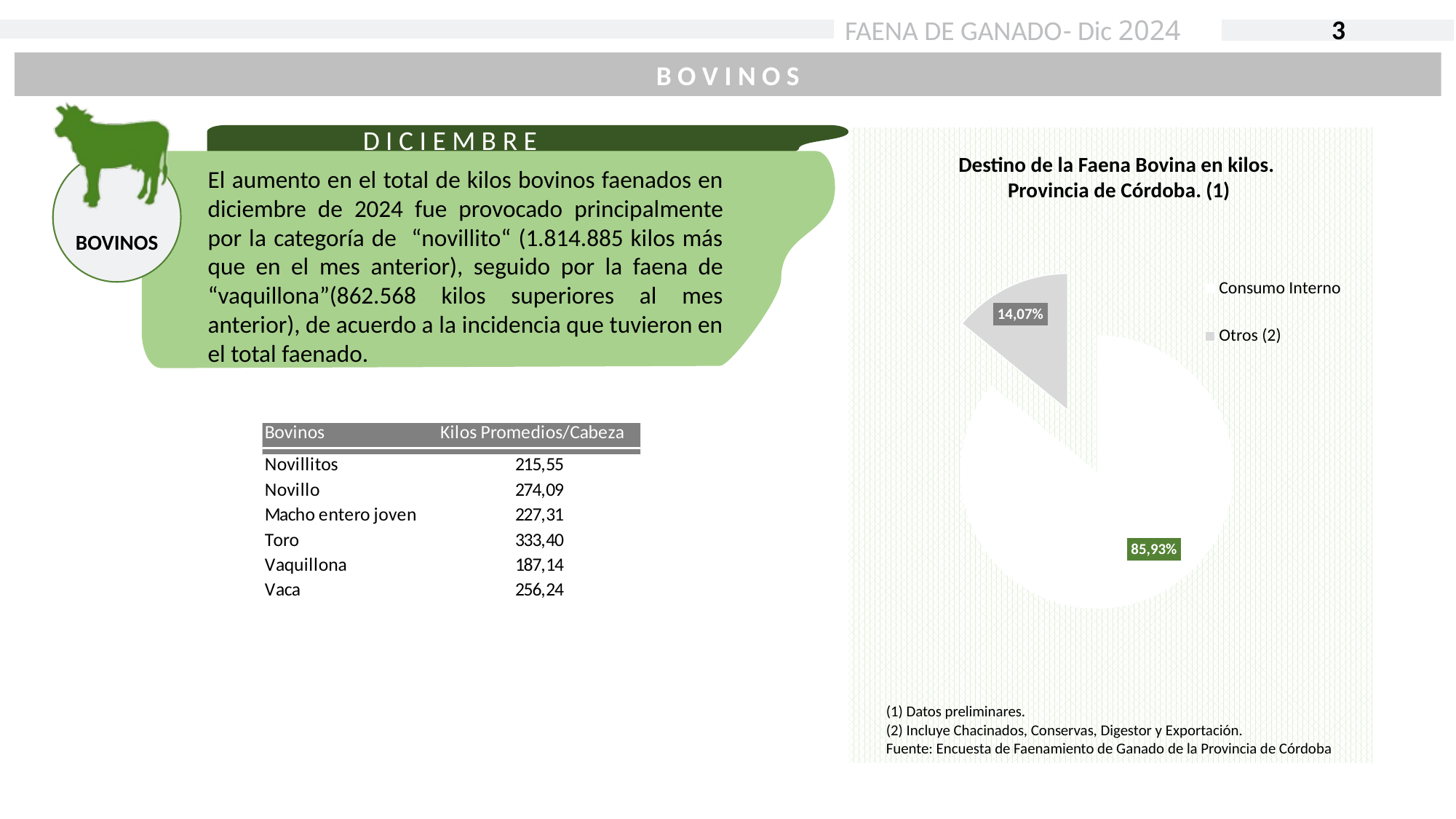
Which slice of the pie chart is the smallest? Otros (2) What is the title of the pie chart? Destino de la Faena Bovina en kilos. Provincia de Córdoba. (1) Which slice of the pie chart is the largest? Consumo Interno What is the difference in percentage points between the Consumo Interno and Otros (2) slices? 71,86 Which is larger in the pie chart, Consumo Interno or Otros (2)? Consumo Interno How many slices does the pie chart have? 2 What kind of chart is shown on the slide? pie chart What is the share of Consumo Interno in the pie chart? 85,93% How many entries does the legend of the pie chart list? 2 What colour is the Otros (2) slice in the pie chart? grey What is the share of Otros (2) in the pie chart? 14,07%